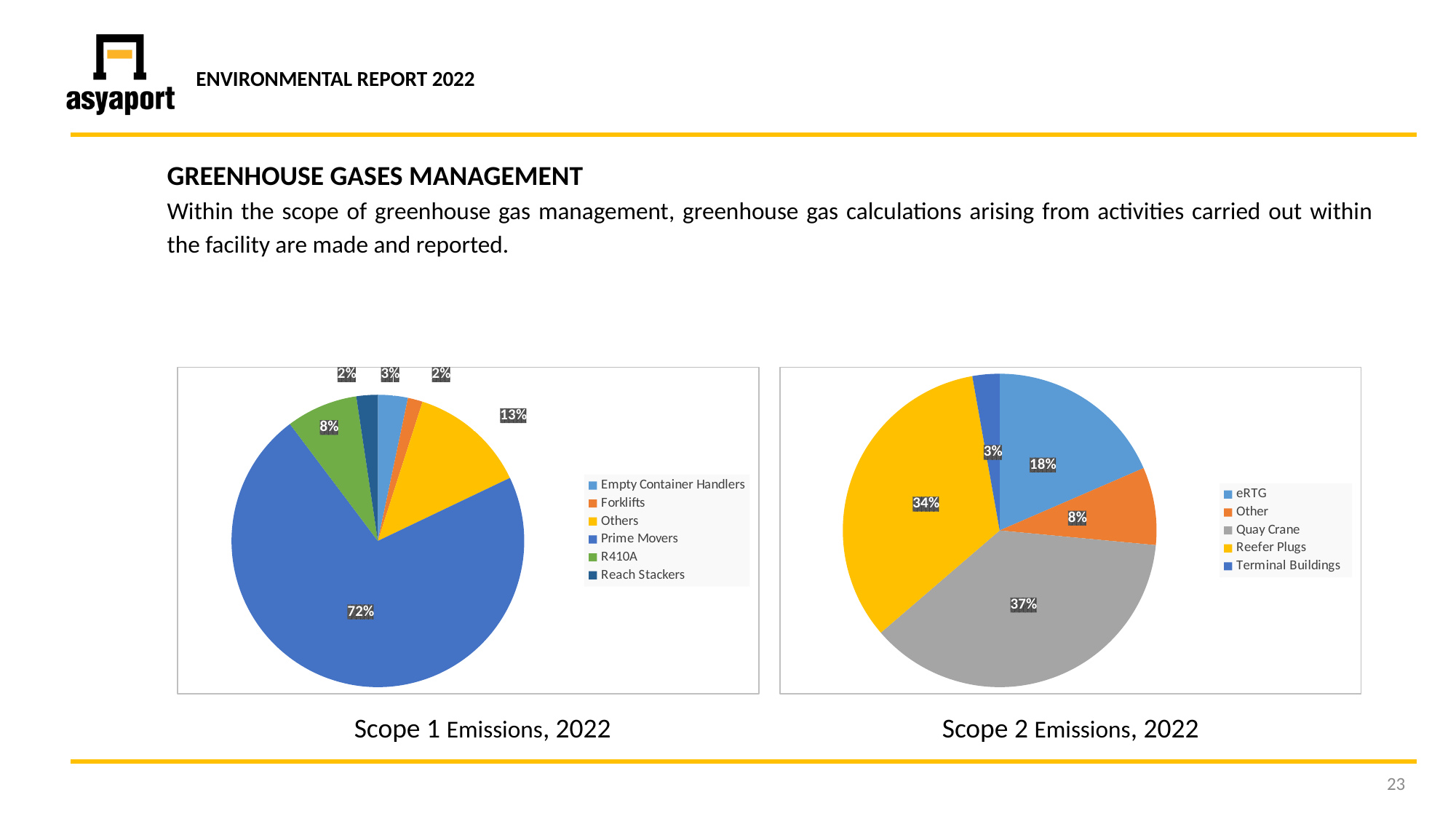
What type of chart is used for Scope 1 Emissions, 2022? pie chart In the Scope 1 Emissions, 2022 chart, which category has the largest share? Prime Movers How many categories does the legend of the Scope 1 Emissions, 2022 chart list? 6 In the Scope 1 Emissions, 2022 chart, what share do Prime Movers have? 72% In the Scope 2 Emissions, 2022 chart, which is larger, eRTG or Other? eRTG In the Scope 2 Emissions, 2022 chart, what share does eRTG have? 18% In the Scope 1 Emissions, 2022 chart, what share does R410A have? 8% In the Scope 1 Emissions, 2022 chart, what share does Others have? 13% In the Scope 2 Emissions, 2022 chart, what share does Quay Crane have? 37% In the Scope 2 Emissions, 2022 chart, what share do Reefer Plugs have? 34% In the Scope 1 Emissions, 2022 chart, what is the difference between the Prime Movers share and the Others share? 59% In the Scope 2 Emissions, 2022 chart, which category has the smallest share? Terminal Buildings